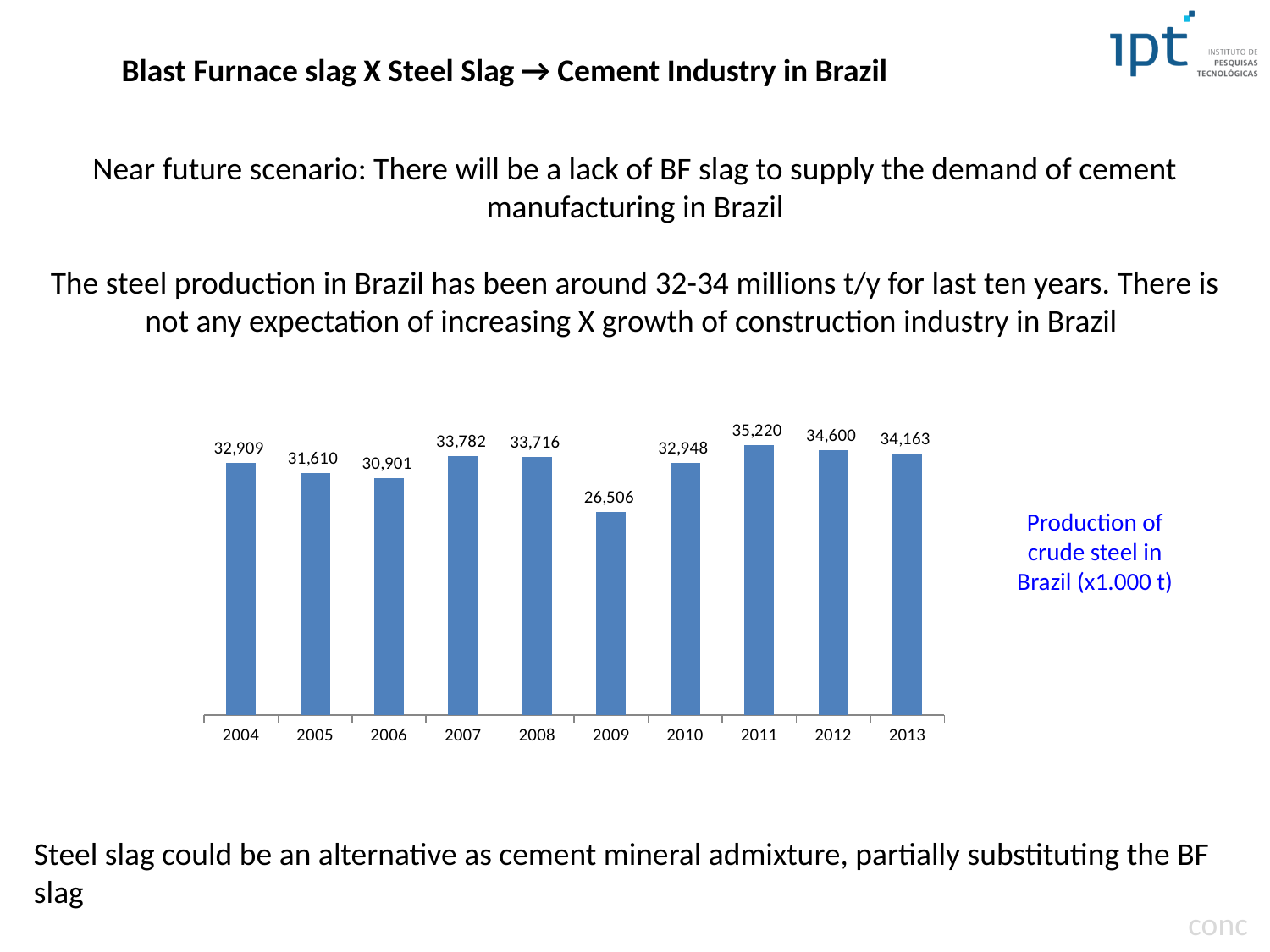
What is the difference between the values for 2012 and 2013? 437 Which year has a larger value, 2005 or 2006? 2005 What is the difference between the values for 2011 and 2009? 8,714 What is the production of crude steel in Brazil for 2011? 35,220 Which year has the lowest crude steel production? 2009 What is the value shown for 2004? 32,909 What is the production of crude steel in Brazil for 2009? 26,506 How many years are shown on the chart? 10 Which year has the highest crude steel production? 2011 What kind of chart is shown on the slide? Bar chart Which year has a larger value, 2007 or 2008? 2007 What unit does the chart caption give for the production values? x1.000 t